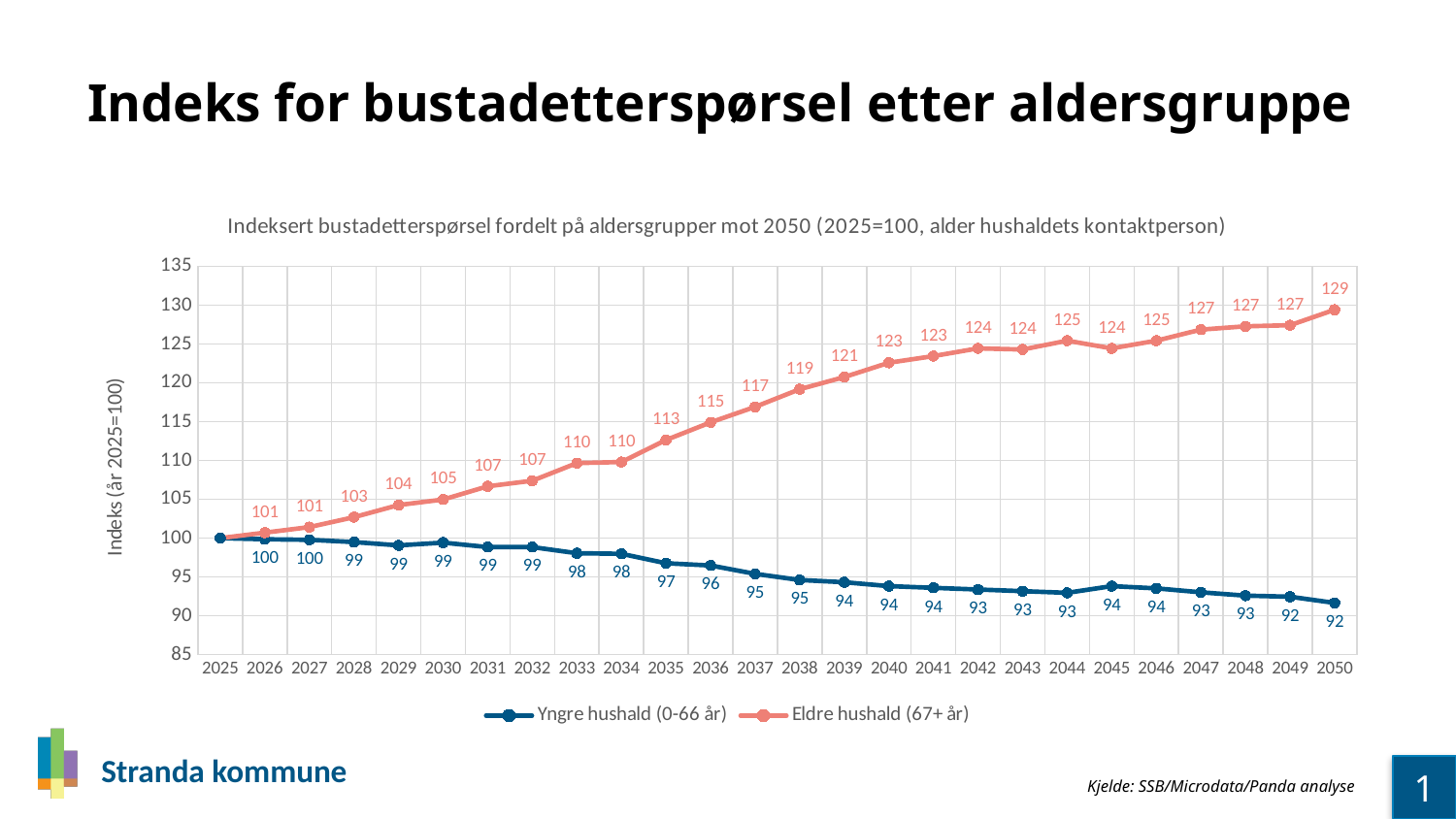
What is the value for Eldre hushald (67+ år) in 2035? 113 How many series does the legend list? 2 How many years are shown on the x axis? 26 What is the difference between Eldre hushald (67+ år) and Yngre hushald (0-66 år) in 2050? 37 Is the value for Eldre hushald (67+ år) in 2025 greater or less than 105? less What is the value for Yngre hushald (0-66 år) in 2040? 94 What is the value for Eldre hushald (67+ år) in 2050? 129 What kind of chart is shown on the slide? line chart Which series has the higher value in 2045, Yngre hushald (0-66 år) or Eldre hushald (67+ år)? Eldre hushald (67+ år) What is the label of the y axis? Indeks (år 2025=100) Does the Yngre hushald (0-66 år) series generally rise or fall from 2025 to 2050? fall Does the Eldre hushald (67+ år) series generally rise or fall from 2025 to 2050? rise